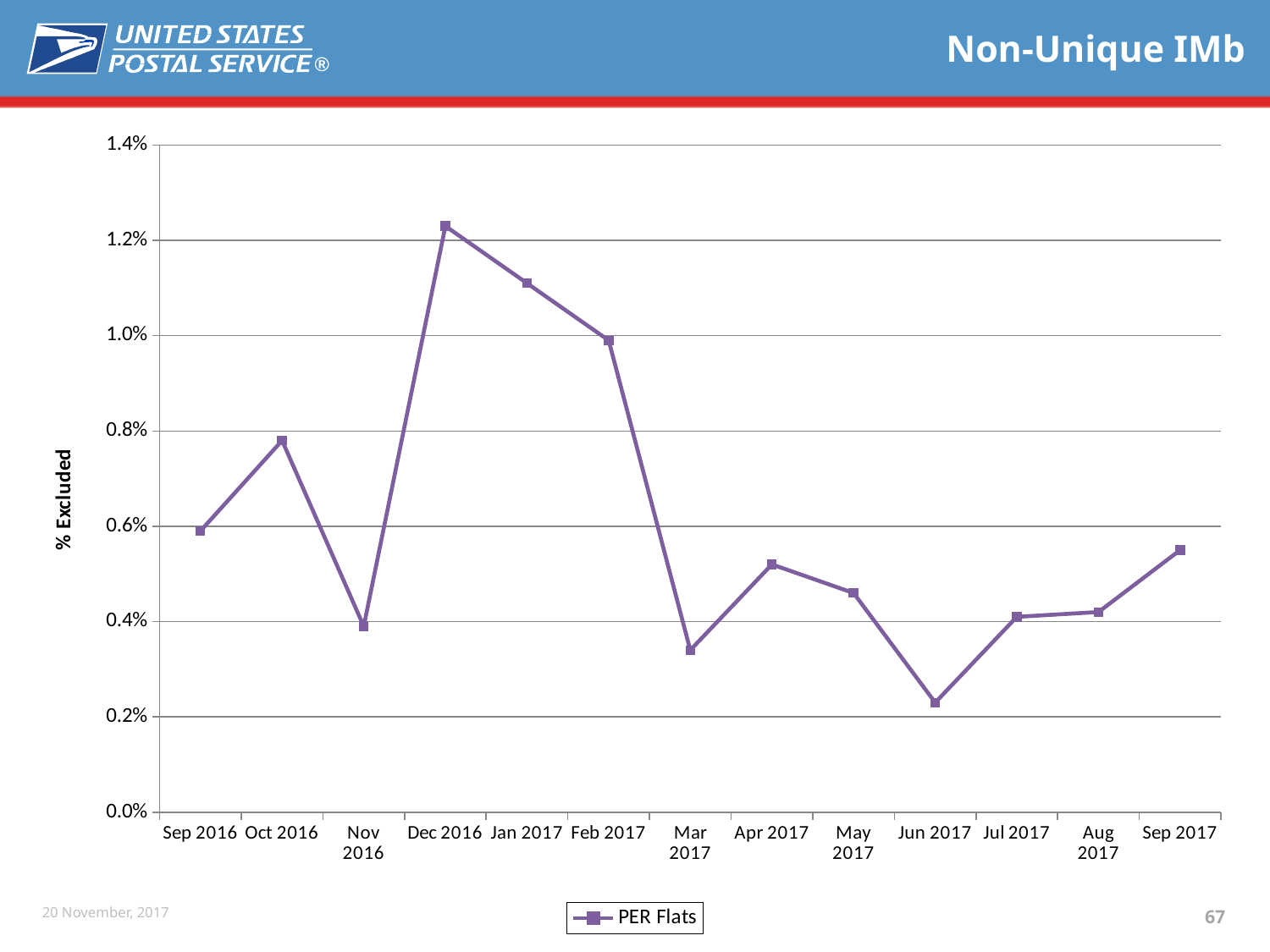
Is the value for Jun 2017 greater or less than 0.4%? less Which is larger, the value for Oct 2016 or the value for Nov 2016? Oct 2016 What kind of chart is shown on the slide? line chart Which month has the lowest % Excluded value? Jun 2017 Is the value for Dec 2016 greater or less than 1.0%? greater Which month has the highest % Excluded value? Dec 2016 Do the values rise or fall from Dec 2016 to Mar 2017? fall How many months are plotted along the x axis? 13 Which is larger, the value for Jan 2017 or the value for Apr 2017? Jan 2017 What is the name of the series shown in the legend? PER Flats Is the value for Oct 2016 greater or less than 0.6%? greater How many series does the legend list? 1